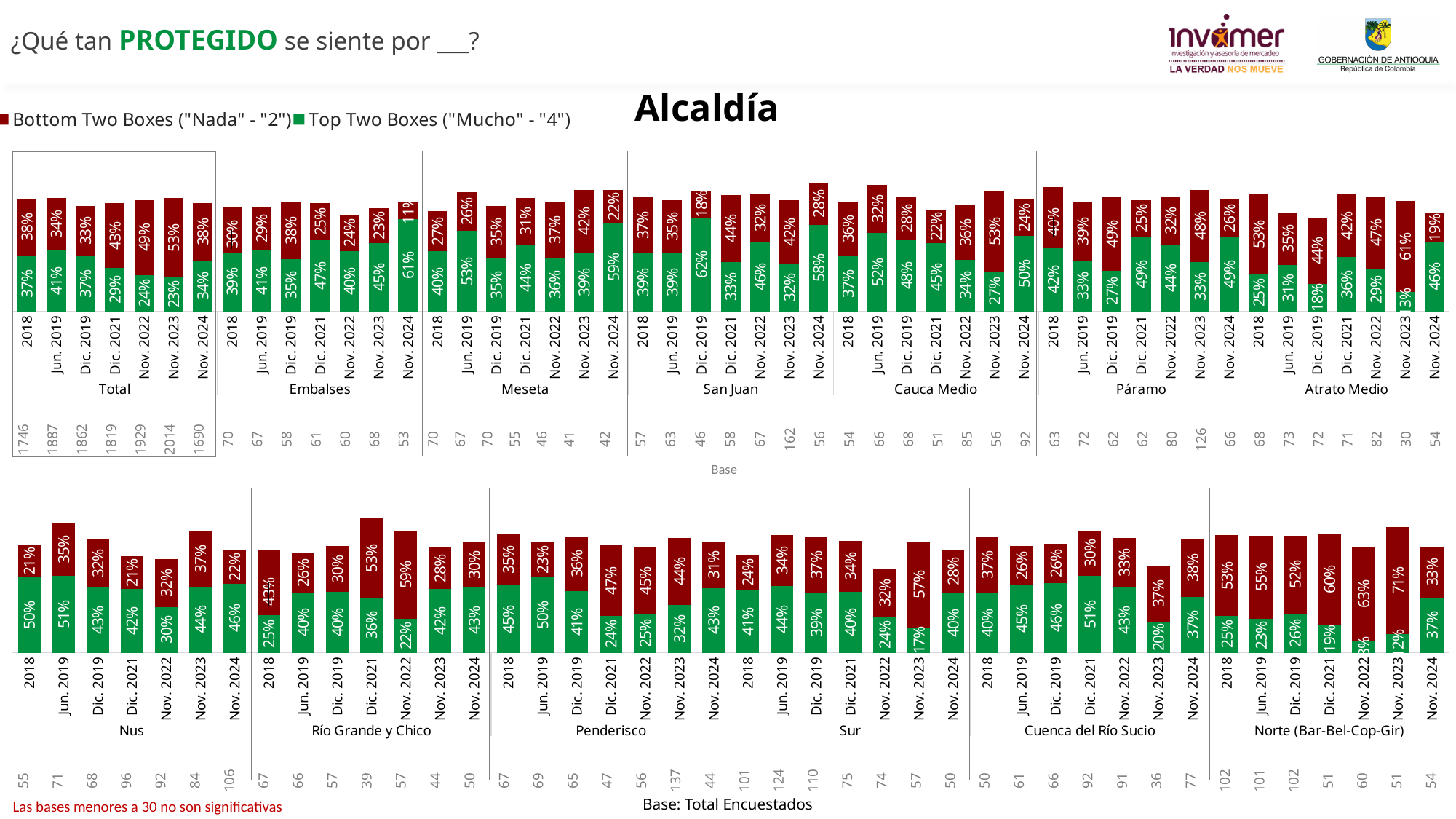
How many series does the legend list? 2 In the bottom chart, which is larger for Nus in Nov. 2022: the Top Two Boxes value or the Bottom Two Boxes value? Bottom Two Boxes In the top chart, what is the base (number of respondents) for Total in Nov. 2023? 2014 In the top chart, which period has the lowest Top Two Boxes value for Total? Nov. 2023 How many periods are plotted for each region in the top chart? 7 In the bottom chart, what is the total of the stacked bar for Sur in Nov. 2023? 74% In the top chart, what is the Top Two Boxes ("Mucho" - "4") value for Total in Nov. 2024? 34% In the top chart, what is the difference between the Bottom Two Boxes and Top Two Boxes values for Total in Nov. 2023? 30% In the bottom chart, what is the Bottom Two Boxes ("Nada" - "2") value for Norte (Bar-Bel-Cop-Gir) in Nov. 2023? 71% What kind of chart is shown on the slide? Stacked bar chart In the top chart, which period has the highest Top Two Boxes value for Embalses? Nov. 2024 In the top chart, what is the Bottom Two Boxes ("Nada" - "2") value for Atrato Medio in Nov. 2023? 61%